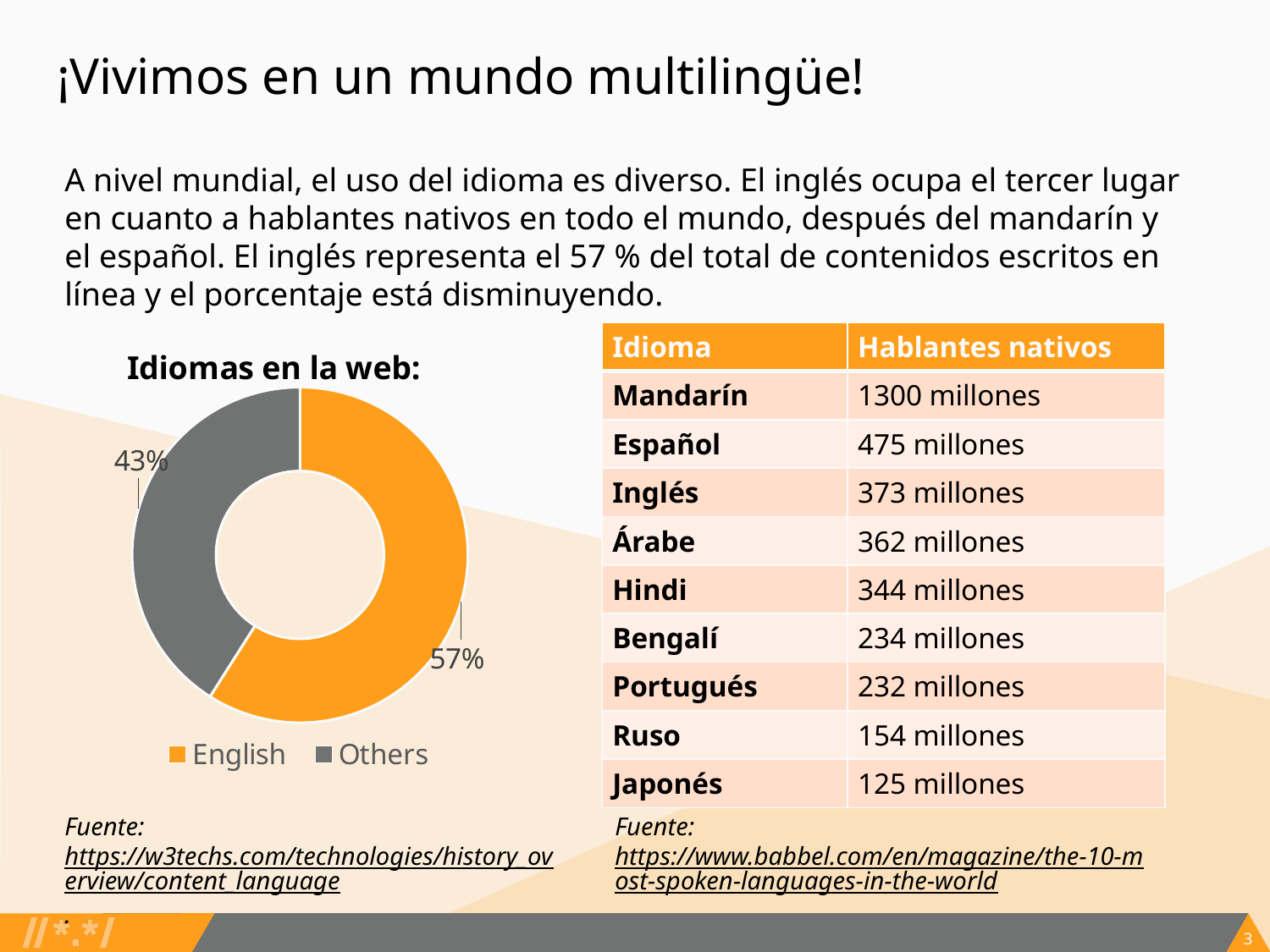
In the "Idiomas en la web:" chart, what share is shown for English? 57% In the "Idiomas en la web:" chart, what colour is the English slice? Orange What kind of chart is shown under the heading "Idiomas en la web:"? Doughnut chart In the "Idiomas en la web:" chart, what colour is the Others slice? Grey In the "Idiomas en la web:" chart, what is the difference in percentage points between English and Others? 14 How many slices does the "Idiomas en la web:" chart have? 2 In the "Idiomas en la web:" chart, what share is shown for Others? 43% In the "Idiomas en la web:" chart, which slice is the largest? English How many entries does the legend of the "Idiomas en la web:" chart list? 2 In the "Idiomas en la web:" chart, is the share for English greater or less than 50%? greater In the "Idiomas en la web:" chart, which is larger, English or Others? English In the "Idiomas en la web:" chart, which slice is the smallest? Others